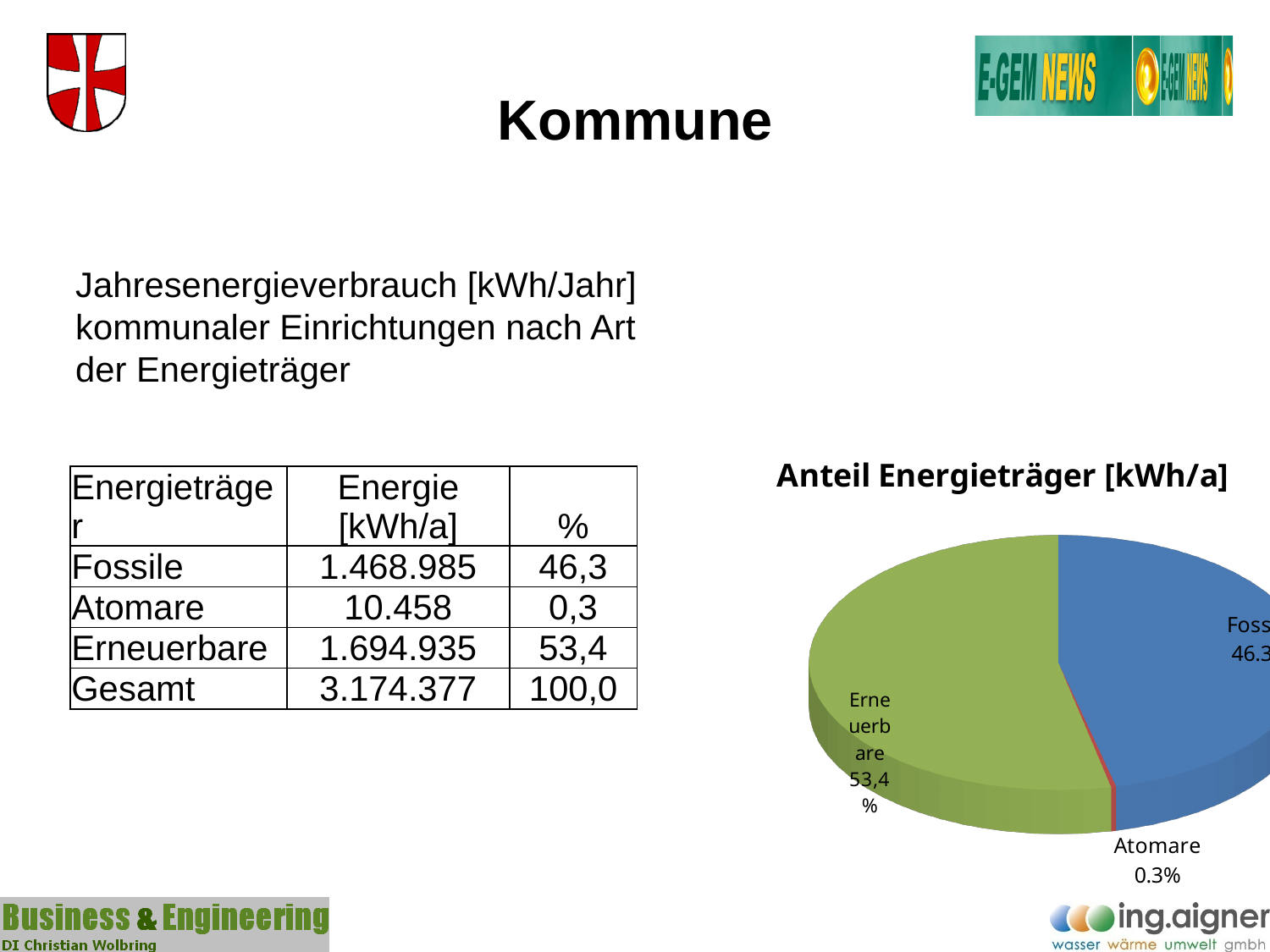
Which slice is larger in the pie chart, Erneuerbare or Atomare? Erneuerbare What is the title of the pie chart? Anteil Energieträger [kWh/a] How many slices does the pie chart have? 3 Which slice of the pie chart is the smallest? Atomare Which slice of the pie chart is the largest? Erneuerbare What share of the pie does Atomare have? 0.3% Which slice is larger in the pie chart, Erneuerbare or Fossile? Erneuerbare What colour is the Erneuerbare slice in the pie chart? green What kind of chart is shown on the slide? pie chart What share of the pie does Erneuerbare have? 53,4 % Is the share of the Erneuerbare slice greater or less than 50%? greater